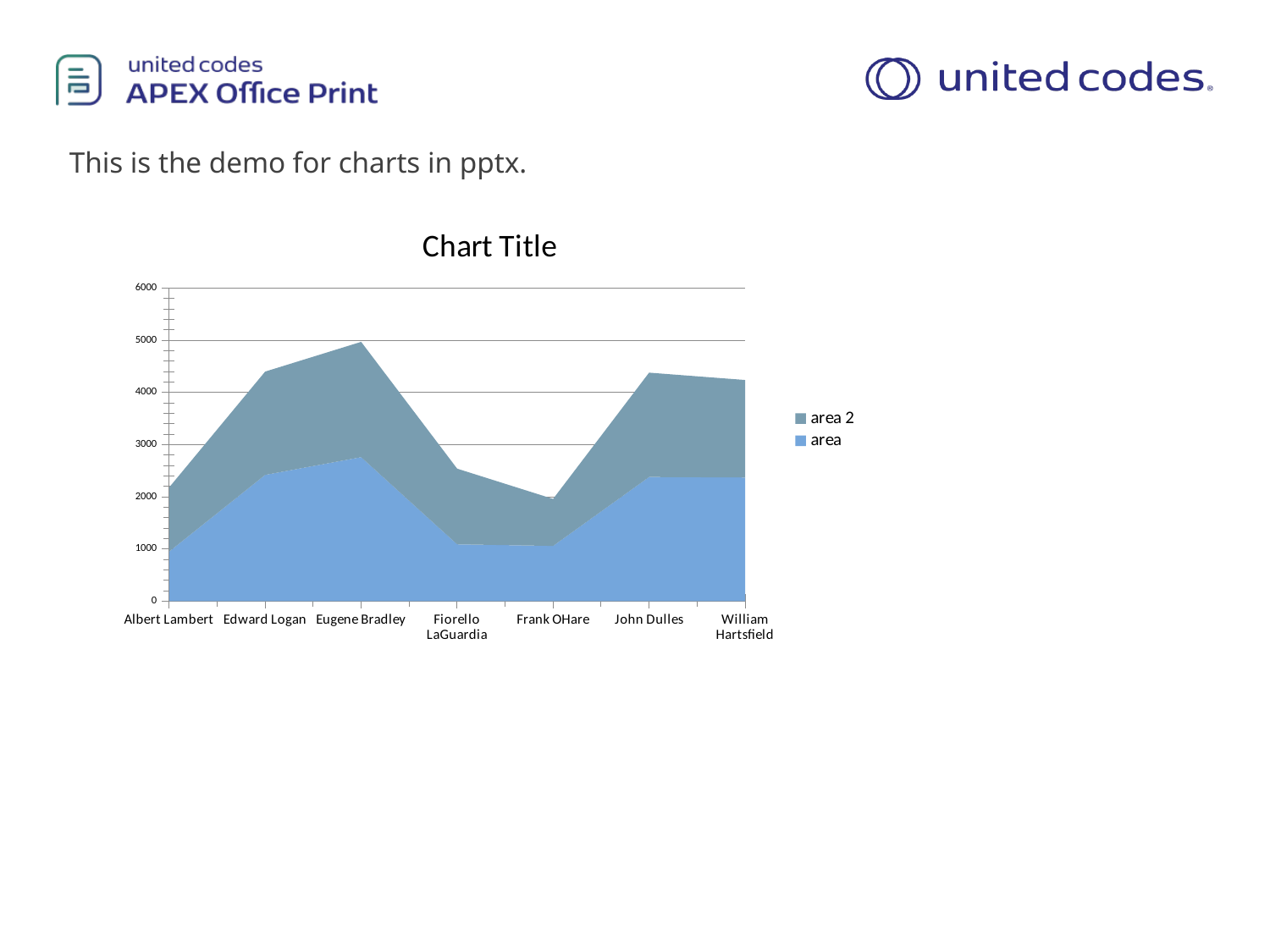
How many categories are shown along the x axis of the chart? 7 What are the two series names listed in the chart's legend? area 2 and area What kind of chart is shown on the slide? area chart Which category has the highest stacked total (top of the 'area 2' band)? Eugene Bradley Is the 'area' series value for Eugene Bradley greater or less than 2000? greater How many series does the chart's legend list? 2 Which category has the highest value for the 'area' series? Eugene Bradley Is the stacked total for Edward Logan greater or less than 4000? greater Is the 'area' series value for Albert Lambert greater or less than 2000? less What is the title of the chart? Chart Title For the 'area' series, which is larger: the value for Edward Logan or the value for Fiorello LaGuardia? Edward Logan Which category has the lowest stacked total (top of the 'area 2' band)? Frank OHare